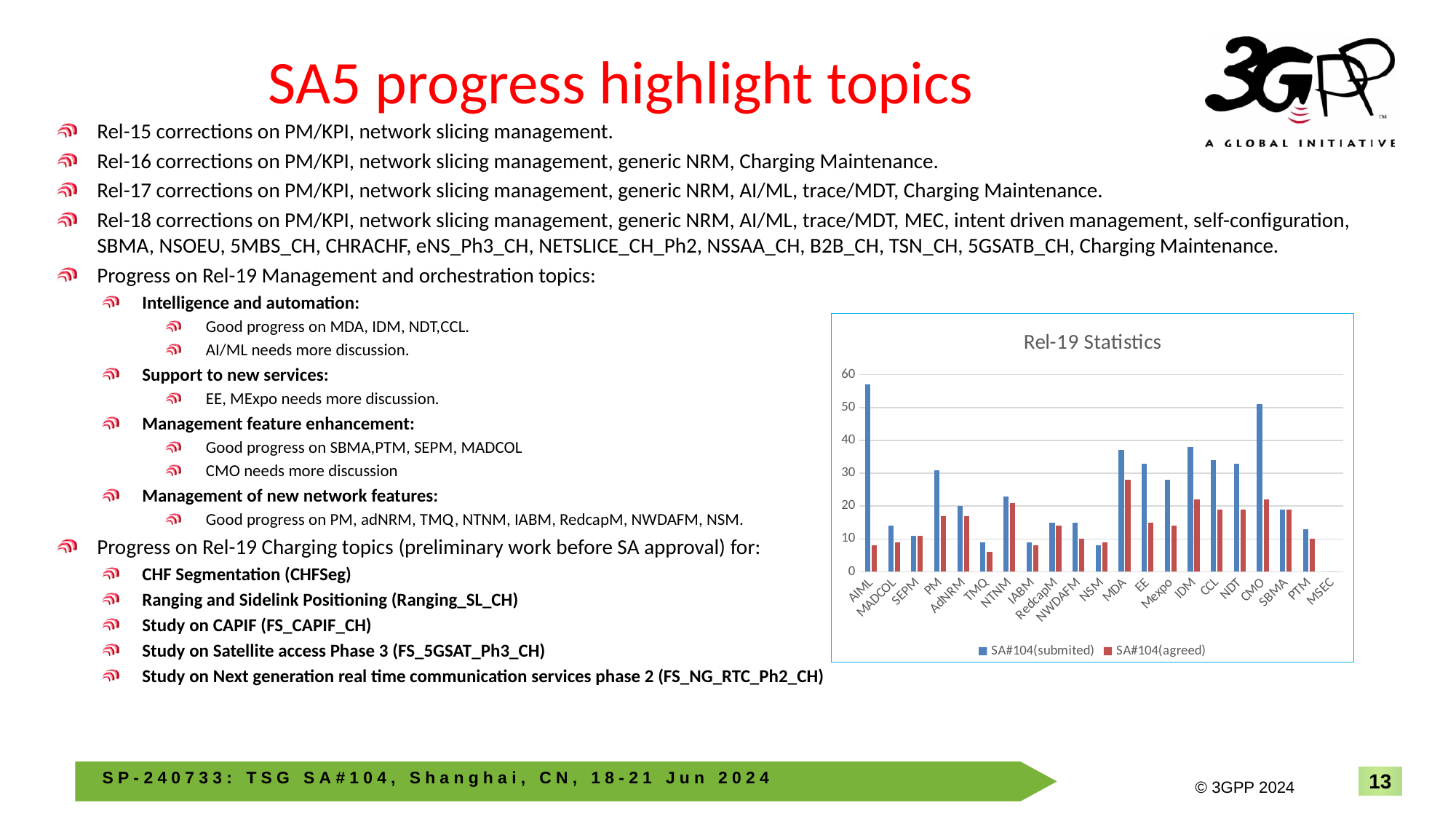
How many categories are shown on the x axis of the Rel-19 Statistics chart? 21 Which is larger in the Rel-19 Statistics chart: the SA#104(agreed) value for MDA or for EE? MDA How many series does the legend of the Rel-19 Statistics chart list? 2 Is the SA#104(submited) value for AIML greater or less than 50? greater What are the two series named in the legend of the Rel-19 Statistics chart? SA#104(submited) and SA#104(agreed) What kind of chart is the Rel-19 Statistics chart? bar chart Which is larger in the Rel-19 Statistics chart: the SA#104(submited) value for AIML or for CMO? AIML Which category has the highest SA#104(agreed) value in the Rel-19 Statistics chart? MDA Which category has the highest SA#104(submited) value in the Rel-19 Statistics chart? AIML Which category has the lowest SA#104(submited) value in the Rel-19 Statistics chart? MSEC What is the title of the chart on the slide? Rel-19 Statistics Is the SA#104(agreed) value for TMQ greater or less than 10? less